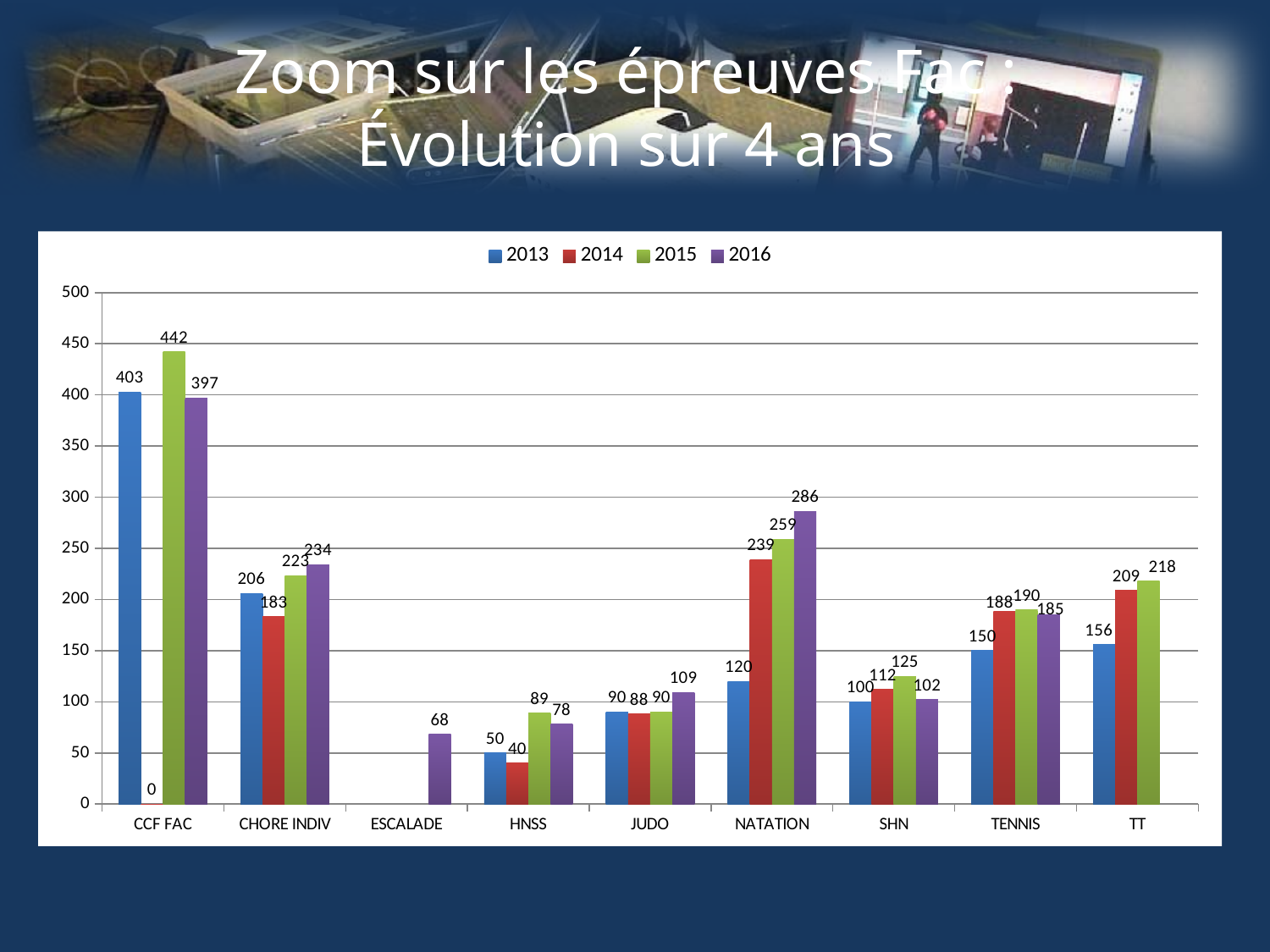
What is the value for TENNIS in 2013? 150 Is the 2016 value for CCF FAC greater or less than 350? greater Which is larger, the 2015 value for CHORE INDIV or the 2015 value for TT? CHORE INDIV Which category has the lowest value in 2013 among those with a 2013 bar? HNSS Which category has the highest value in 2016? CCF FAC What is the difference between the 2016 and 2013 values for NATATION? 166 Do the values for NATATION rise or fall from 2013 to 2016? Rise What kind of chart is shown on the slide? Bar chart How many categories are shown on the x axis? 9 What is the value for CCF FAC in 2015? 442 How many series does the legend list? 4 What is the value for NATATION in 2016? 286